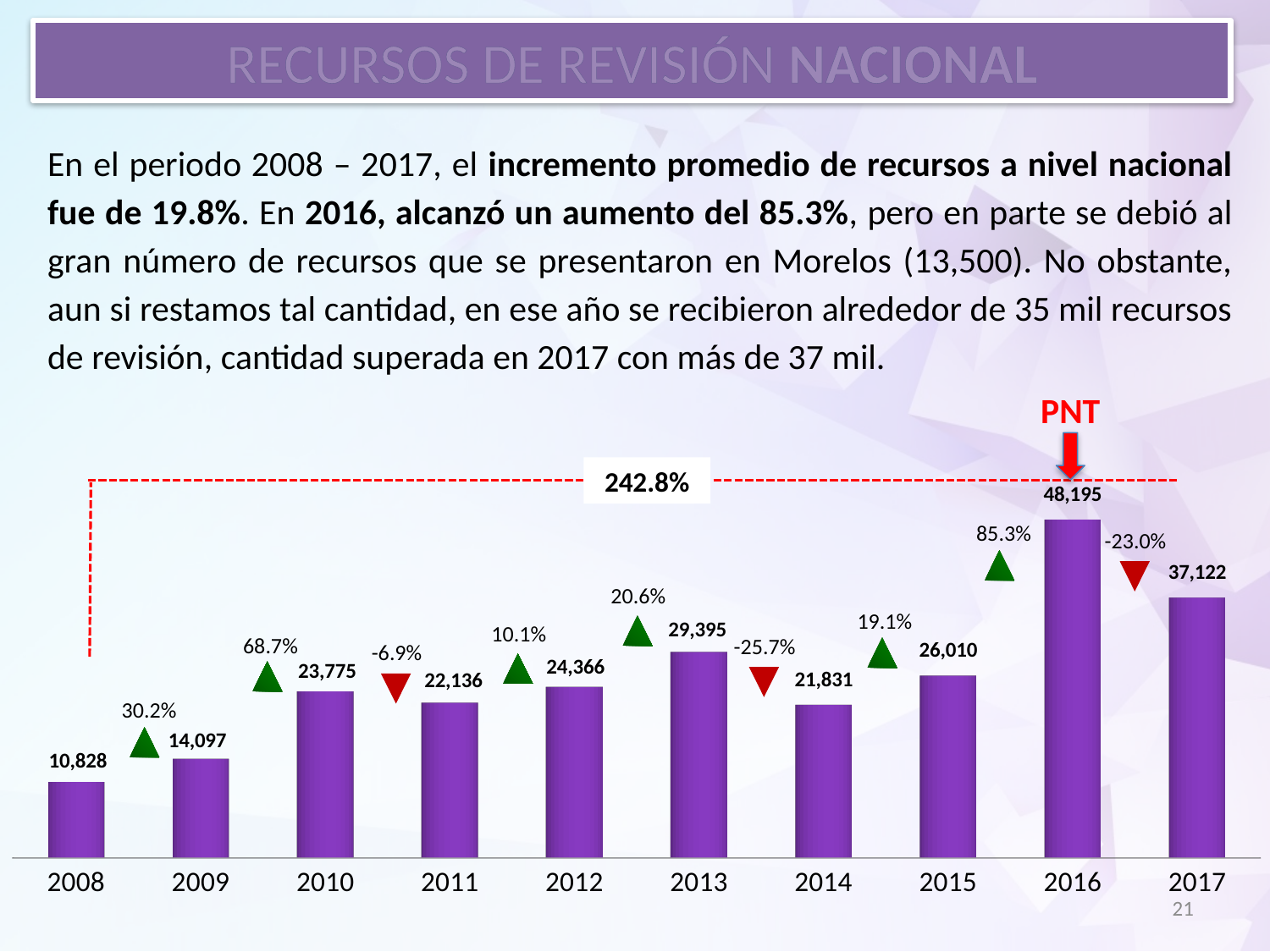
Which is larger, the value for 2014 or the value for 2015? 2015 What is the value for 2013? 29,395 Which year has the highest value? 2016 What percentage change is shown between 2015 and 2016? 85.3% How many years are shown on the x axis? 10 What is the value for 2008? 10,828 What is the value for 2016? 48,195 What is the difference between the values for 2016 and 2017? 11,073 What overall percentage is shown on the dashed red line spanning from 2008 to 2016? 242.8% What is the difference between the values for 2010 and 2011? 1,639 What kind of chart is this? bar chart Which year has the lowest value? 2008